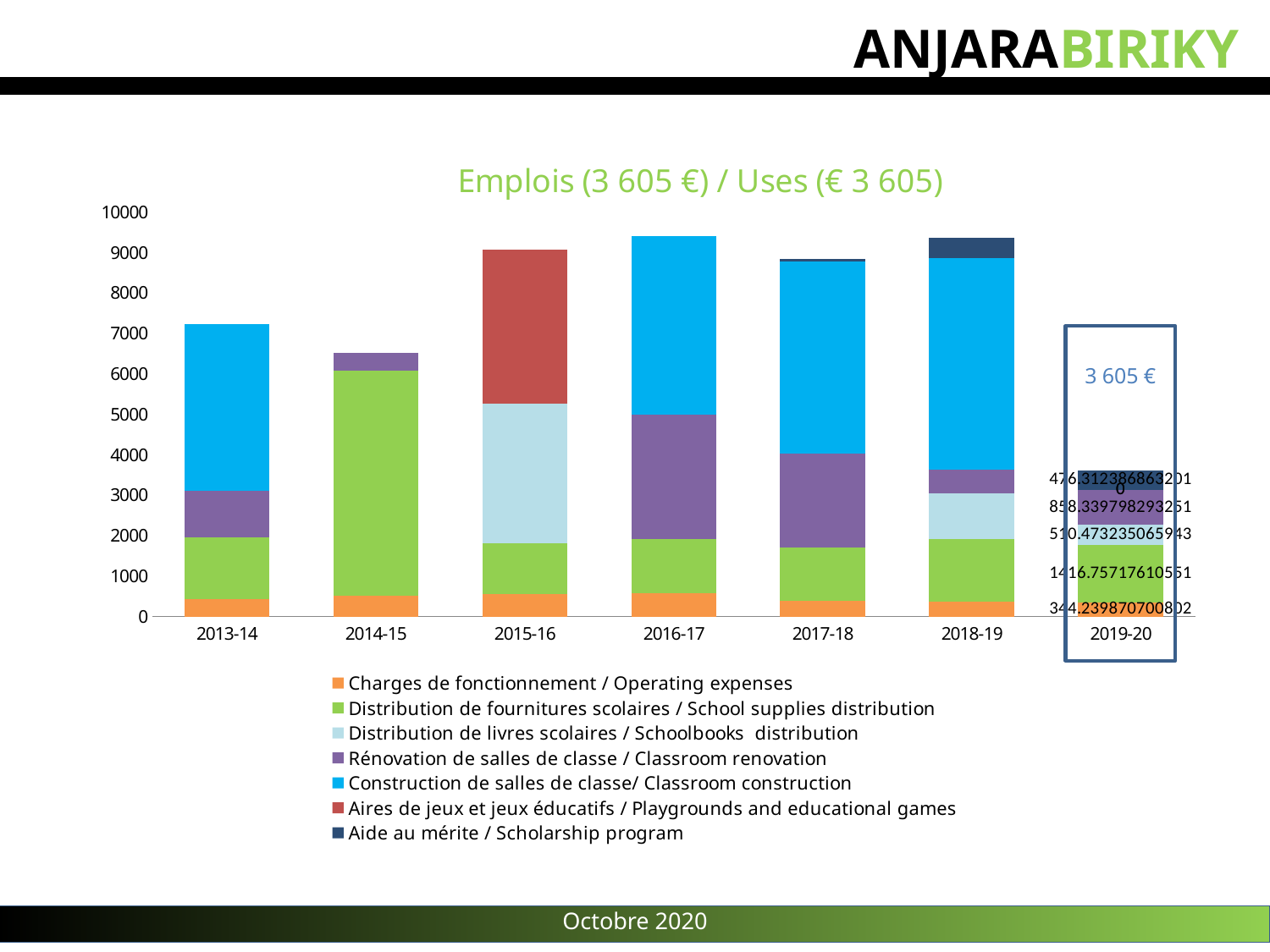
Is the total for 2014-15 greater or less than 7000? less Is the total for 2013-14 greater or less than 7000? greater In which year does the 'Aires de jeux et jeux éducatifs / Playgrounds and educational games' series appear in the chart? 2015-16 Which year has the larger total bar, 2014-15 or 2015-16? 2015-16 What kind of chart is shown on the slide? Stacked bar chart What is the title of the chart? Emplois (3 605 €) / Uses (€ 3 605) Is the total for 2016-17 greater or less than 9000? greater Which year has the larger total bar, 2013-14 or 2014-15? 2013-14 How many series does the chart legend list? 7 What total value is annotated next to the 2019-20 bar? 3 605 € How many year categories are shown on the x axis of the chart? 7 Which year has the lowest total bar in the chart? 2019-20